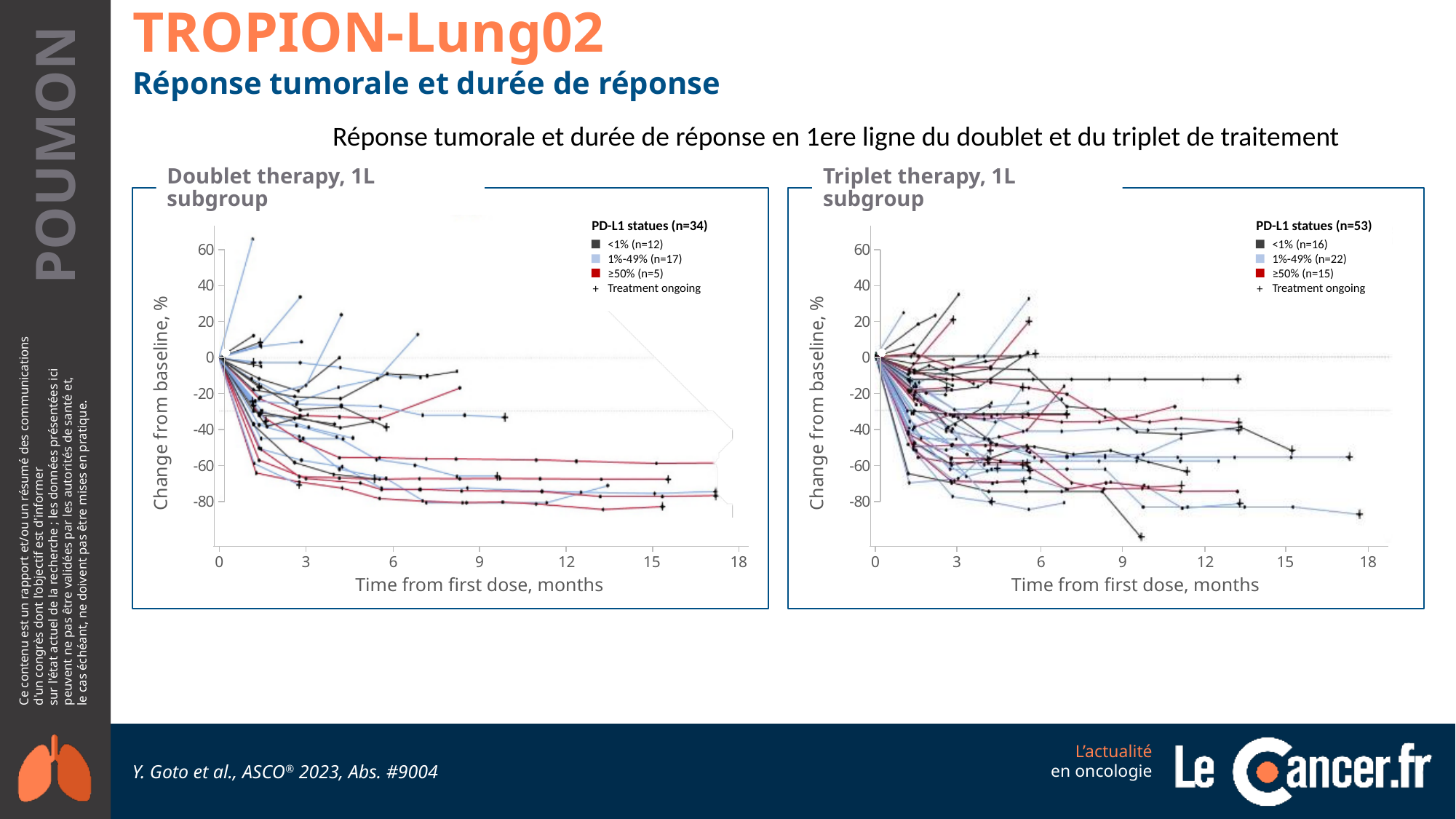
In the Triplet therapy, 1L subgroup chart, how many PD-L1 status categories does the legend list? 3 What is the x-axis label of the Doublet therapy, 1L subgroup chart? Time from first dose, months What is the highest tick value on the x axis of the Triplet therapy, 1L subgroup chart? 18 What is the difference in the number of patients between the Triplet therapy legend (n=53) and the Doublet therapy legend (n=34)? 19 In the Triplet therapy, 1L subgroup chart, how many patients does the legend give for the ≥50% PD-L1 group? n=15 What kind of chart is the Doublet therapy, 1L subgroup chart? line chart In the Triplet therapy, 1L subgroup chart, is the lowest change from baseline shown greater or less than -80? less In the Doublet therapy, 1L subgroup chart, do most patients' values rise or fall over time from first dose? fall Which chart has the larger number of patients in its legend, Doublet therapy (n=34) or Triplet therapy (n=53)? Triplet therapy In the Doublet therapy, 1L subgroup chart, is the highest change from baseline shown greater or less than 60? greater In the Doublet therapy, 1L subgroup chart, how many PD-L1 status categories does the legend list? 3 In the Triplet therapy, 1L subgroup chart, is the highest change from baseline shown greater or less than 40? less